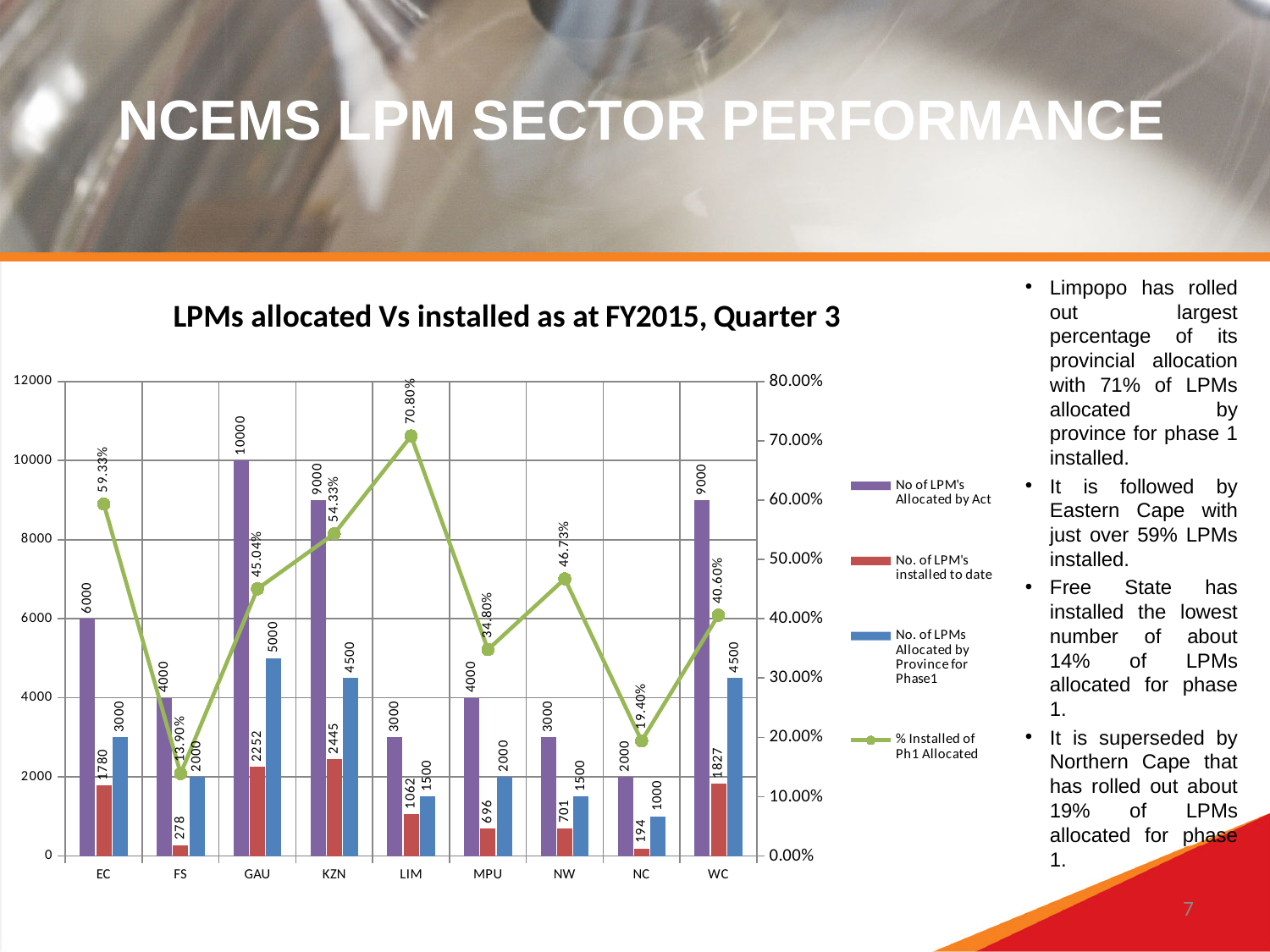
Which province has the lowest No. of LPM's installed to date? NC What kind of chart is this? Combined bar and line chart What is the value of No. of LPMs Allocated by Province for Phase1 for WC? 4500 How many series does the legend list? 4 What is the value of No. of LPM's installed to date for KZN? 2445 What is the value of No of LPM's Allocated by Act for GAU? 10000 What is the title of the chart? LPMs allocated Vs installed as at FY2015, Quarter 3 Which province has the highest % Installed of Ph1 Allocated? LIM How many provinces are shown on the x axis? 9 What is the % Installed of Ph1 Allocated for LIM? 70.80% What is the difference between No of LPM's Allocated by Act and No. of LPM's installed to date for EC? 4220 Which is larger, the No. of LPM's installed to date for GAU or for WC? GAU